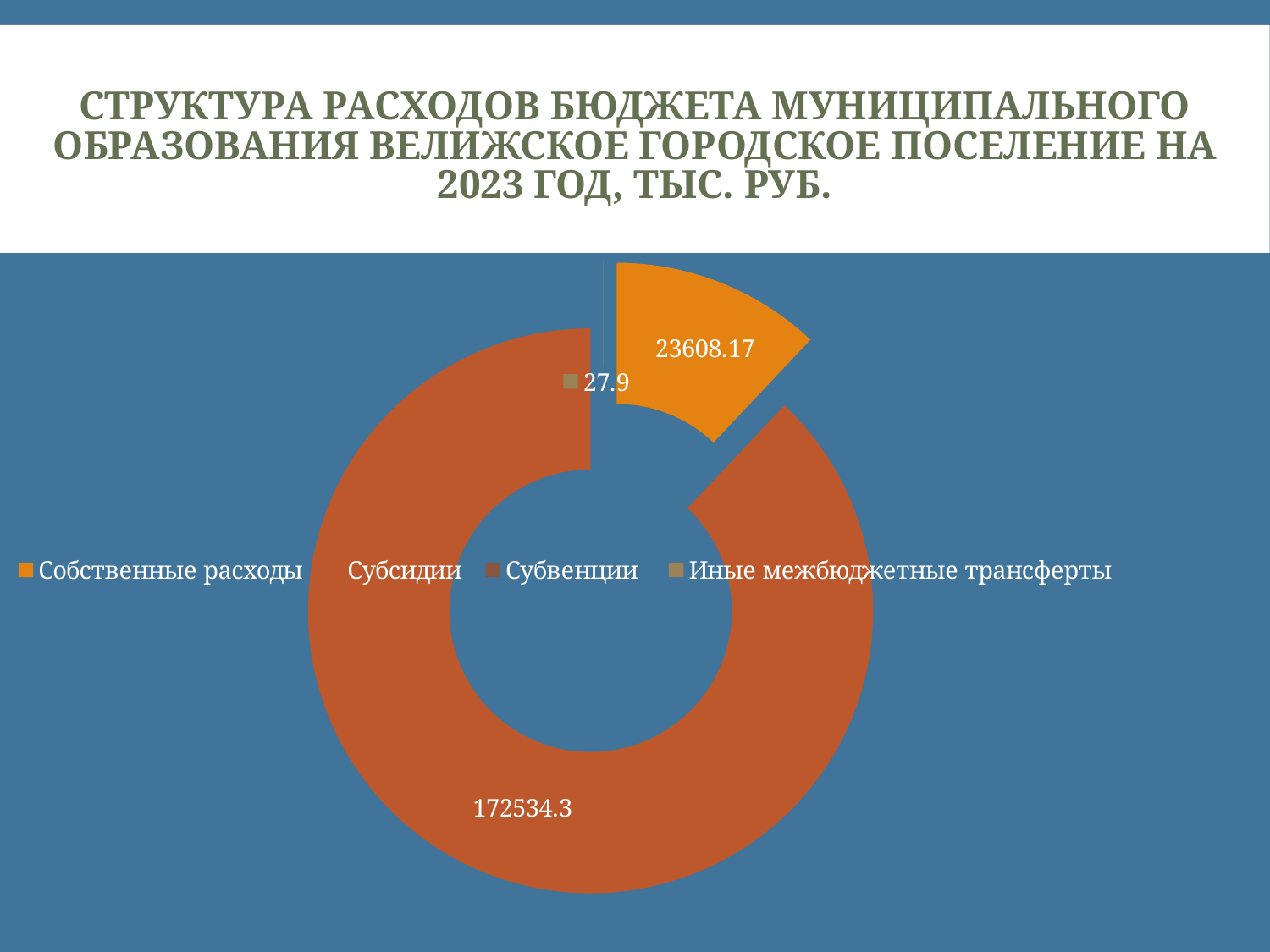
What is the difference between the value for Собственные расходы (23608.17) and the value for Иные межбюджетные трансферты (27.9)? 23580.27 What kind of chart is shown on the slide? Doughnut (pie) chart What is the value shown for Собственные расходы? 23608.17 What is the title of the slide? Структура расходов бюджета муниципального образования Велижское городское поселение на 2023 год, тыс. руб. What is the value shown for Иные межбюджетные трансферты? 27.9 What is the value printed on the largest slice of the chart? 172534.3 How many data labels are printed on the chart? 3 What is the smallest value printed on the chart? 27.9 How many categories does the legend list? 4 Which is larger: the value for Собственные расходы or the value for Иные межбюджетные трансферты? Собственные расходы What colour is the slice for Собственные расходы? Orange In what units are the values on the chart given, according to the title? тыс. руб.